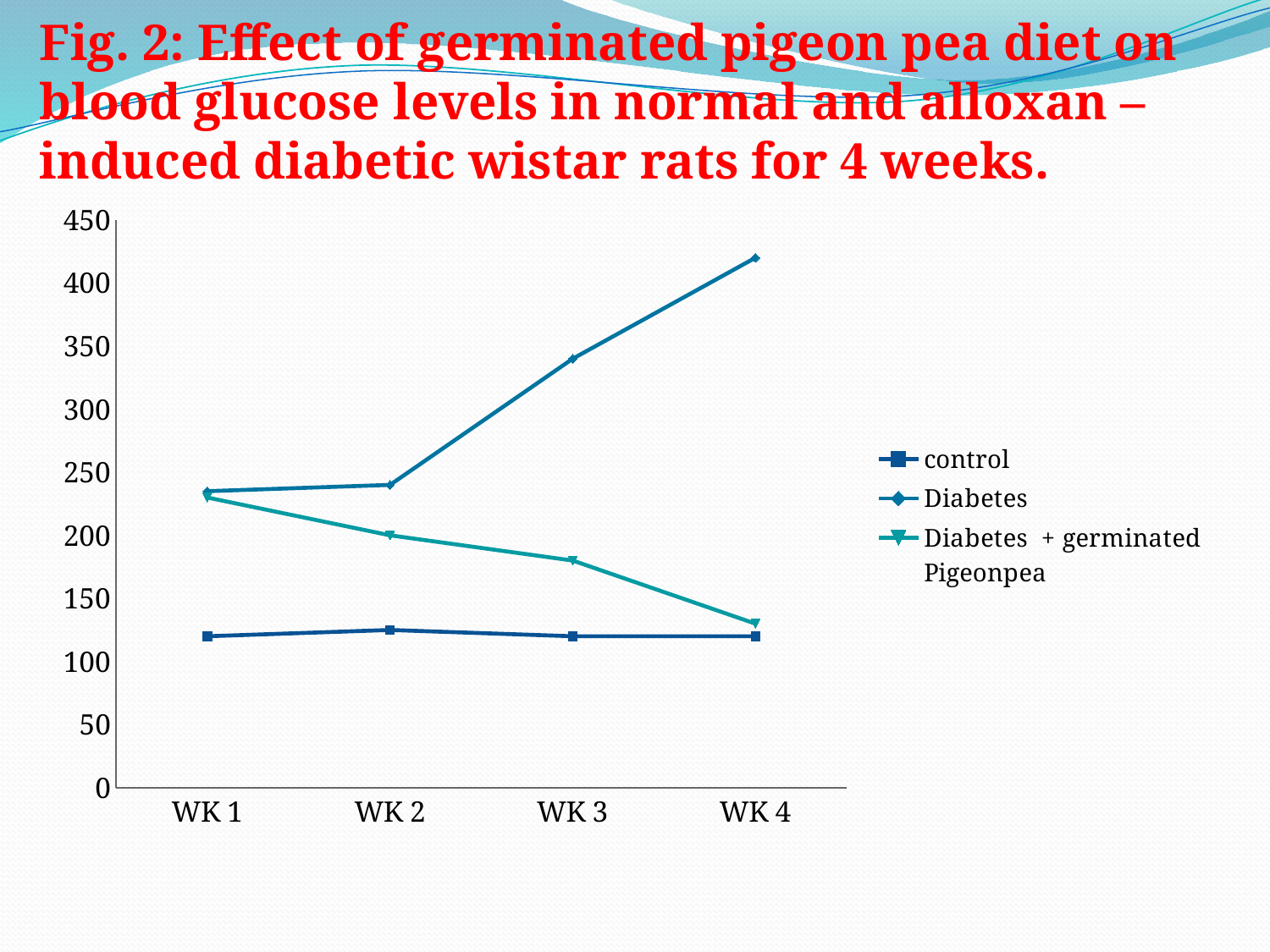
What kind of chart is shown on the slide? line chart Is the value for Diabetes + germinated Pigeonpea at WK 3 greater or less than 200? less Which series has the highest value at WK 4? Diabetes Is the value for control at WK 1 greater or less than 150? less Is the value for Diabetes at WK 3 greater or less than 300? greater Which series has the lowest value at WK 3? control Does the Diabetes + germinated Pigeonpea series rise or fall from WK 1 to WK 4? fall Does the Diabetes series rise or fall from WK 1 to WK 4? rise How many series does the legend list? 3 How many time points are shown on the x axis? 4